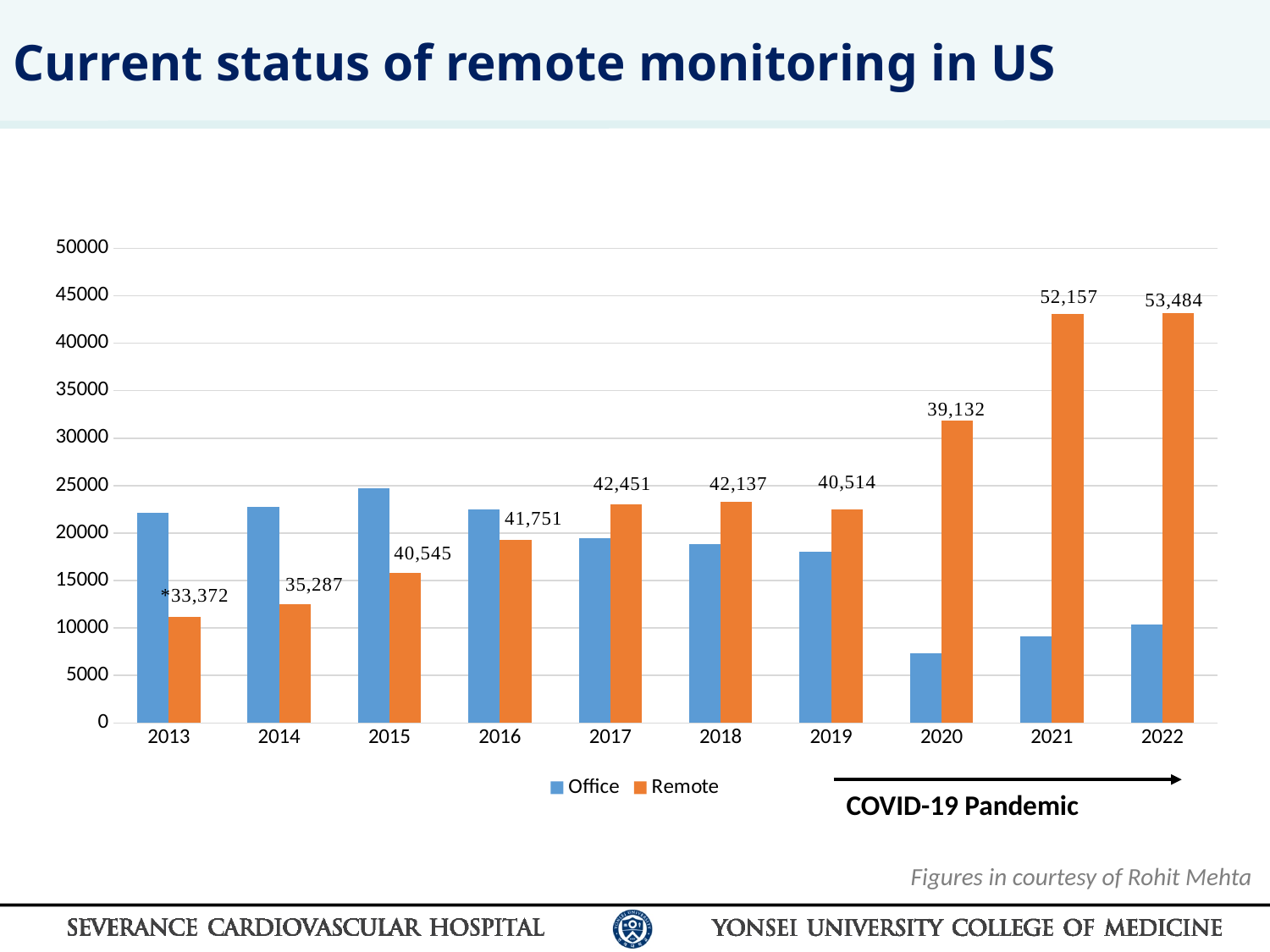
What number is printed above the bars for 2017? 42,451 How many years are shown on the x axis? 10 In 2020, which is larger, the Office bar or the Remote bar? Remote In which year is the Office bar the lowest? 2020 What number is printed above the bars for 2020? 39,132 In which year is the Remote bar the lowest? 2013 What kind of chart is shown on the slide? bar chart How many series does the legend list? 2 Is the Remote value for 2022 greater or less than 40000? greater In which year is the Office bar the highest? 2015 Is the Office value for 2020 greater or less than 10000? less What number is printed above the bars for 2021? 52,157